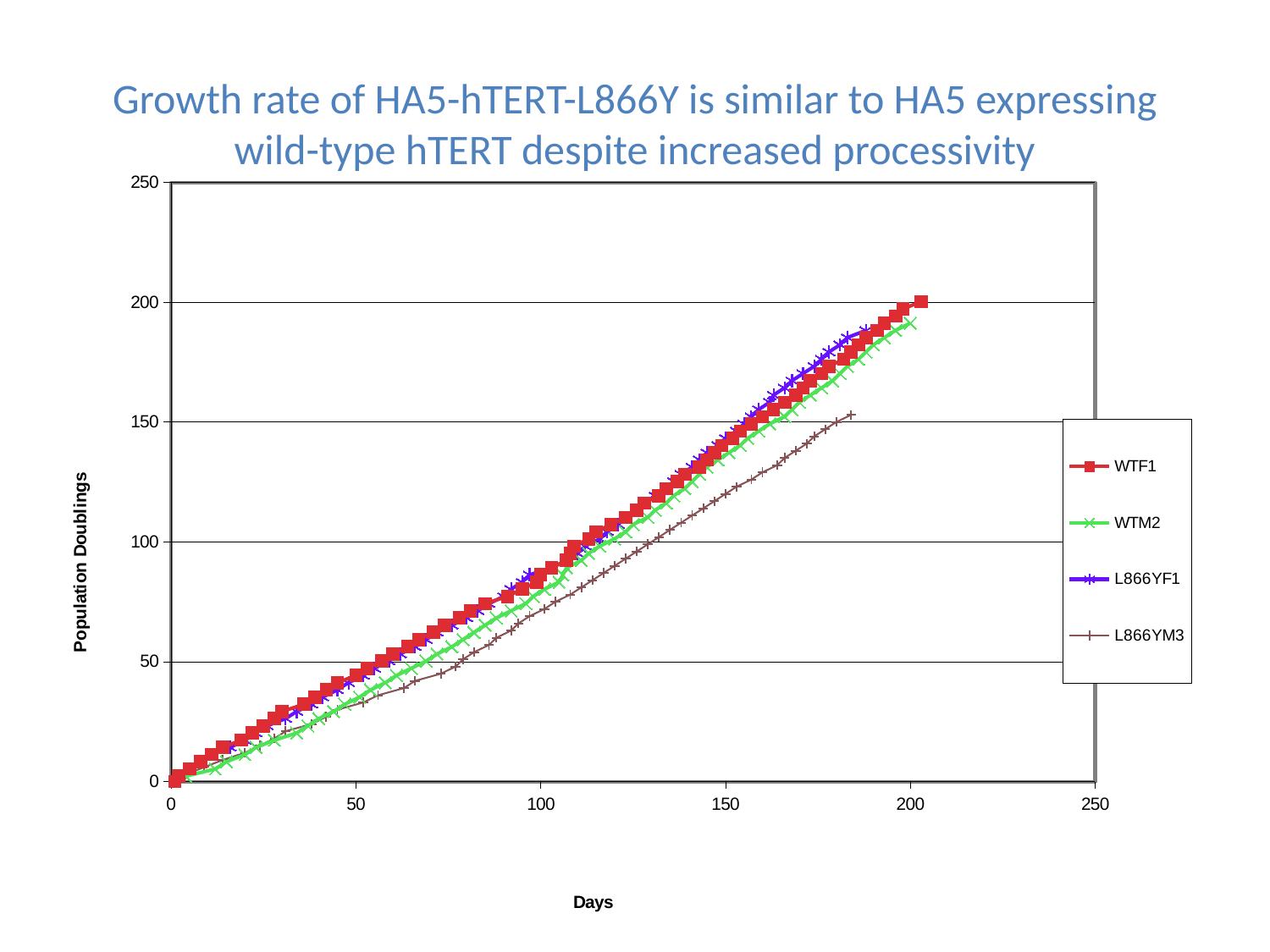
Is the value for WTF1 at 100 days greater or less than 100? less What is the label of the y axis? Population Doublings At 150 days, which series has more population doublings, WTF1 or L866YM3? WTF1 What are the four series listed in the legend? WTF1, WTM2, L866YF1, L866YM3 How many series does the legend list? 4 Is the value for L866YM3 at 100 days greater or less than 100? less What kind of chart is shown on the slide? line chart Do the population doublings rise or fall as the days increase? rise Is the value for L866YM3 at 150 days greater or less than 150? less Which series ends at the fewest days on the x axis? L866YM3 Which series has the lowest population doublings at 150 days? L866YM3